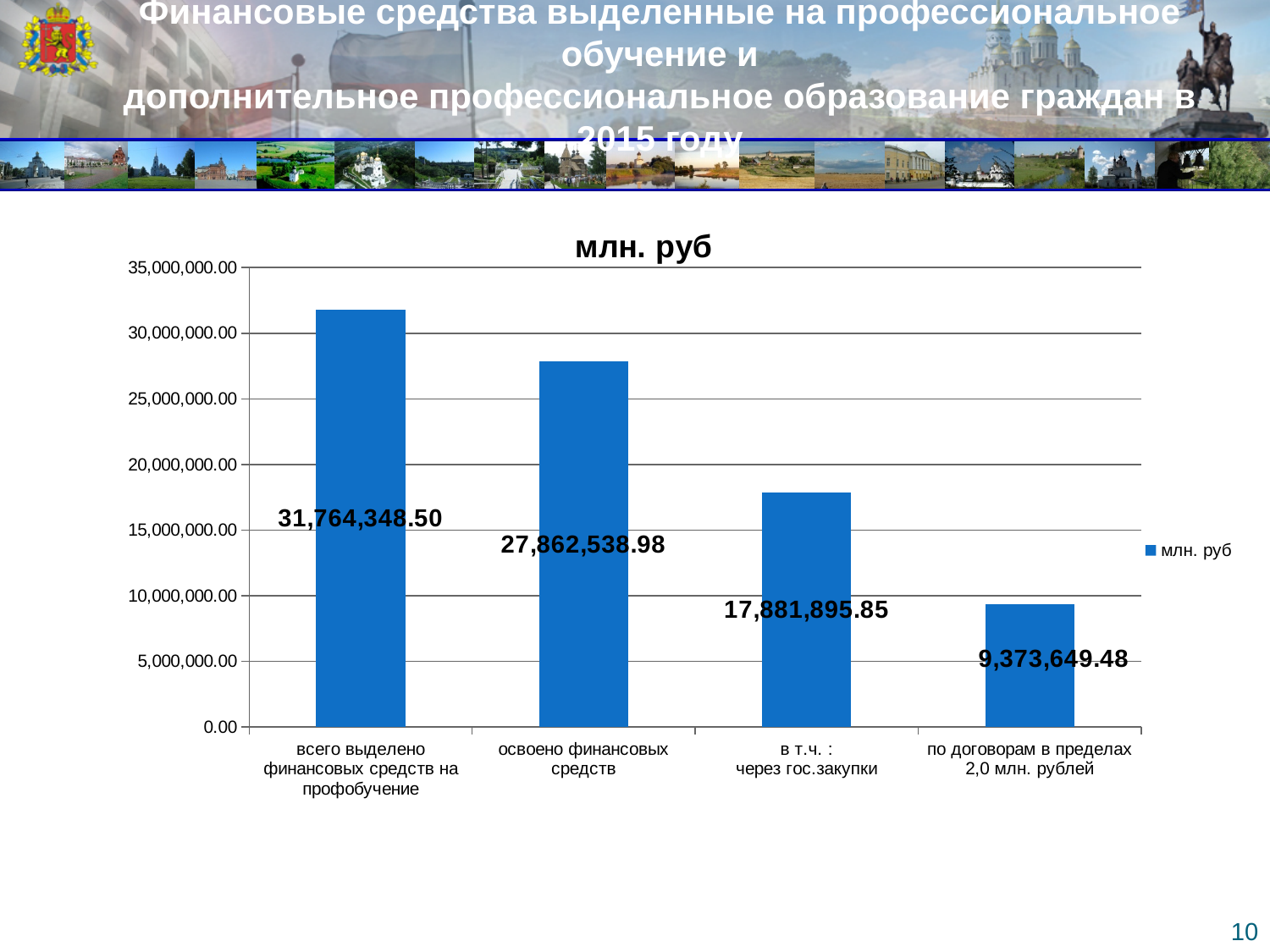
What is the value for 'по договорам в пределах 2,0 млн. рублей'? 9,373,649.48 What type of chart is shown on the slide? bar chart Do the values rise or fall from left to right along the x axis? fall What is the difference between the value for 'всего выделено финансовых средств на профобучение' and the value for 'освоено финансовых средств'? 3,901,809.52 How many series does the legend list? 1 What is the value for 'в т.ч.: через гос.закупки'? 17,881,895.85 How many categories are shown on the x axis of the chart? 4 What is the title of the chart? млн. руб What is the value for 'всего выделено финансовых средств на профобучение'? 31,764,348.50 Which category has the lowest value? по договорам в пределах 2,0 млн. рублей What is the value for 'освоено финансовых средств'? 27,862,538.98 Which category has the highest value? всего выделено финансовых средств на профобучение